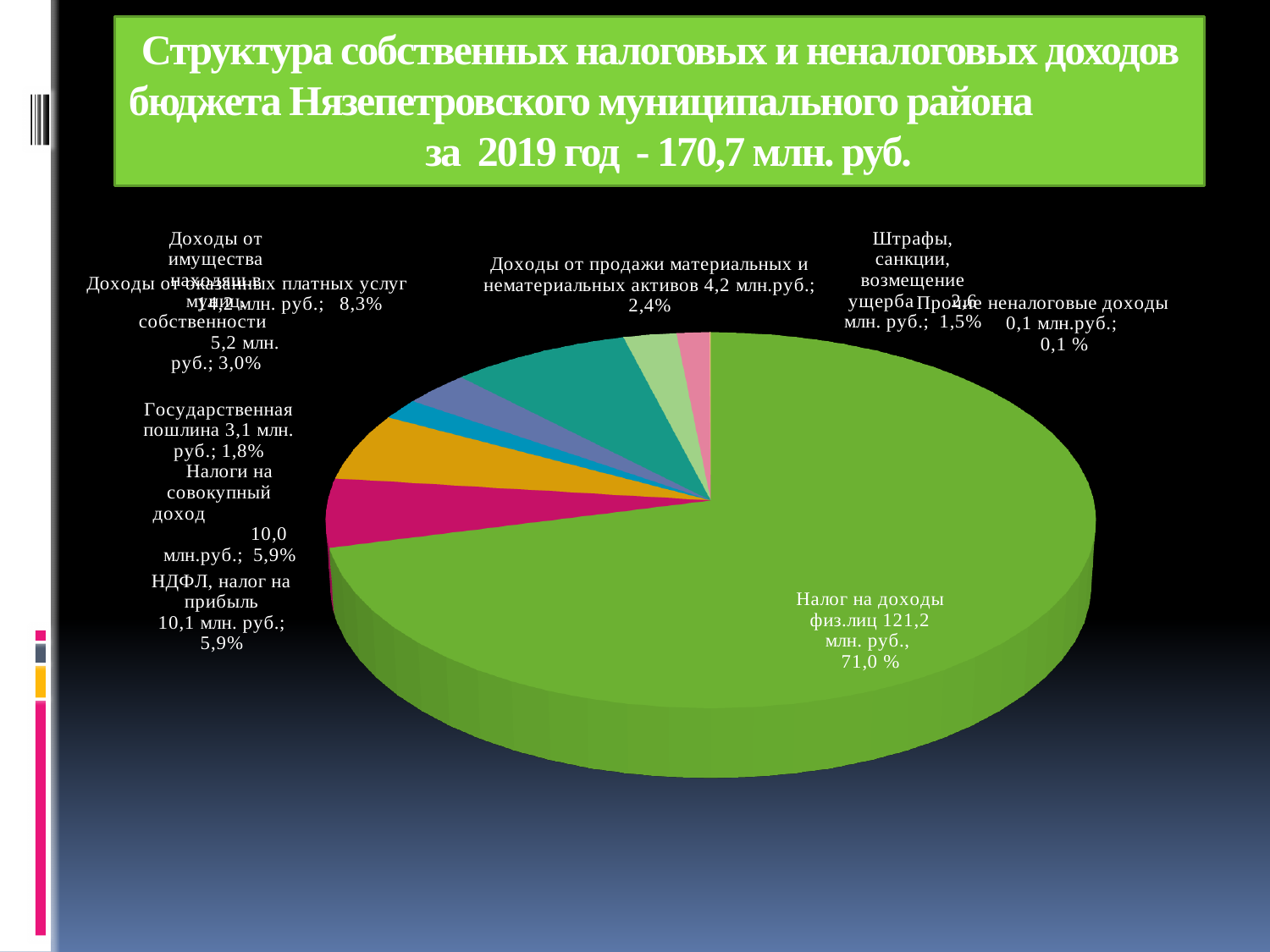
What share of the pie do Доходы от оказанных платных услуг represent? 8,3% What is the value for Налог на доходы физ.лиц? 121,2 млн. руб. What share of the pie does Налог на доходы физ.лиц represent? 71,0 % What share of the pie do Штрафы, санкции, возмещение ущерба represent? 1,5% What is the value for Государственная пошлина? 3,1 млн. руб. What is the value for Прочие неналоговые доходы? 0,1 млн.руб. What is the difference between НДФЛ, налог на прибыль and Налоги на совокупный доход? 0,1 млн. руб. Which is larger: Доходы от продажи материальных и нематериальных активов or Доходы от имущества находящ. в муниц. собственности? Доходы от имущества находящ. в муниц. собственности Which category has the smallest slice of the pie? Прочие неналоговые доходы Which category has the largest slice of the pie? Налог на доходы физ.лиц According to the chart title, what is the total of own tax and non-tax revenues for 2019? 170,7 млн. руб. What kind of chart is shown on the slide? pie chart